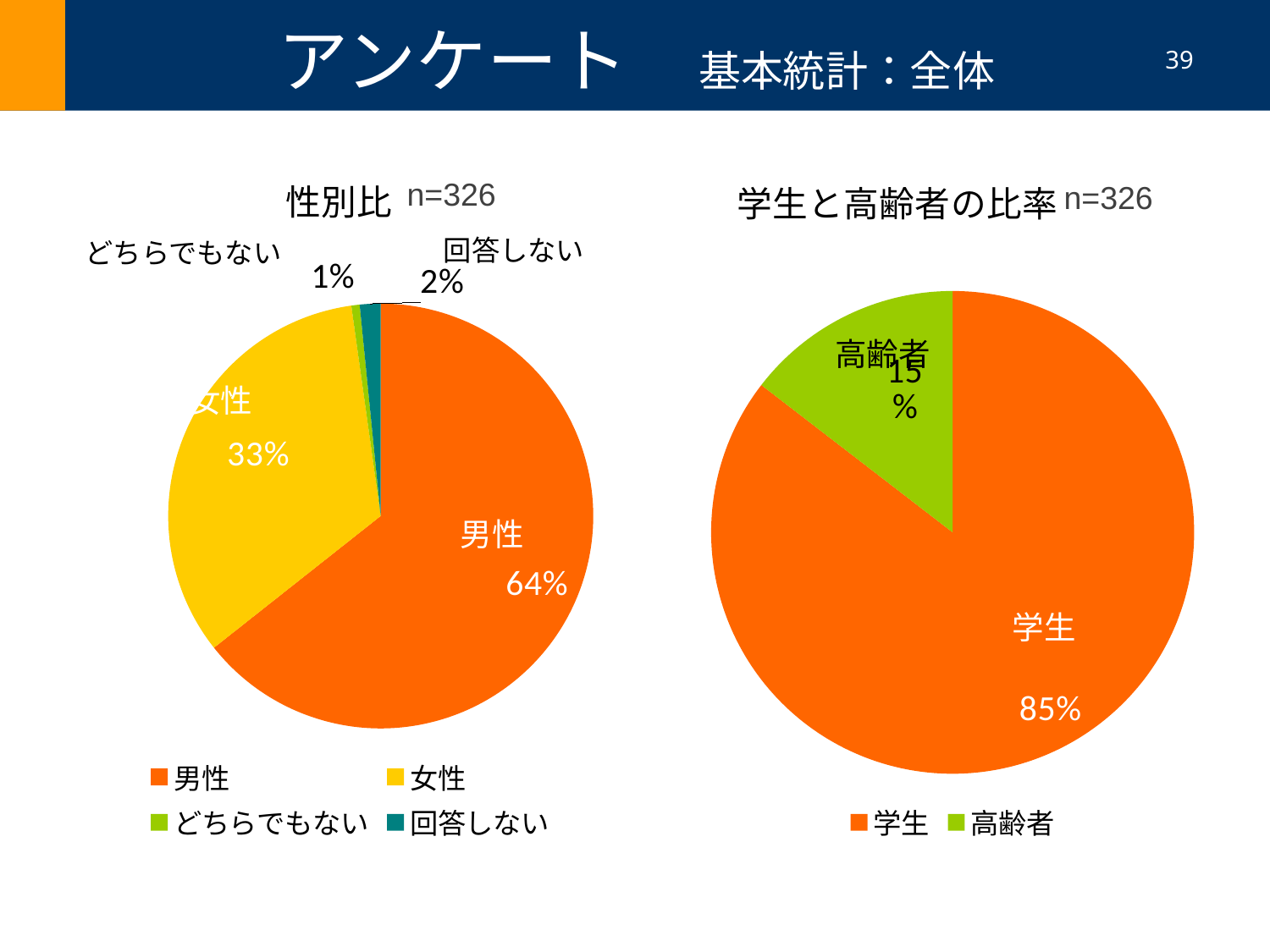
In the 性別比 pie chart, what share is labelled for 回答しない? 2% In the 性別比 pie chart, which category has the smallest slice? どちらでもない In the 性別比 pie chart, how many categories does the legend list? 4 In the 性別比 pie chart, which category has the largest slice? 男性 In the 性別比 pie chart, what share is labelled for どちらでもない? 1% In the 性別比 pie chart, what is the difference in percentage points between 男性 and 女性? 31 In the 学生と高齢者の比率 pie chart, what share is labelled for 高齢者? 15% In the 性別比 pie chart, what share is labelled for 女性? 33% In the 学生と高齢者の比率 pie chart, what share is labelled for 学生? 85% In the 学生と高齢者の比率 pie chart, which is larger, 学生 or 高齢者? 学生 What kind of chart is the 学生と高齢者の比率 chart? pie chart In the 性別比 pie chart, what share is labelled for 男性? 64%